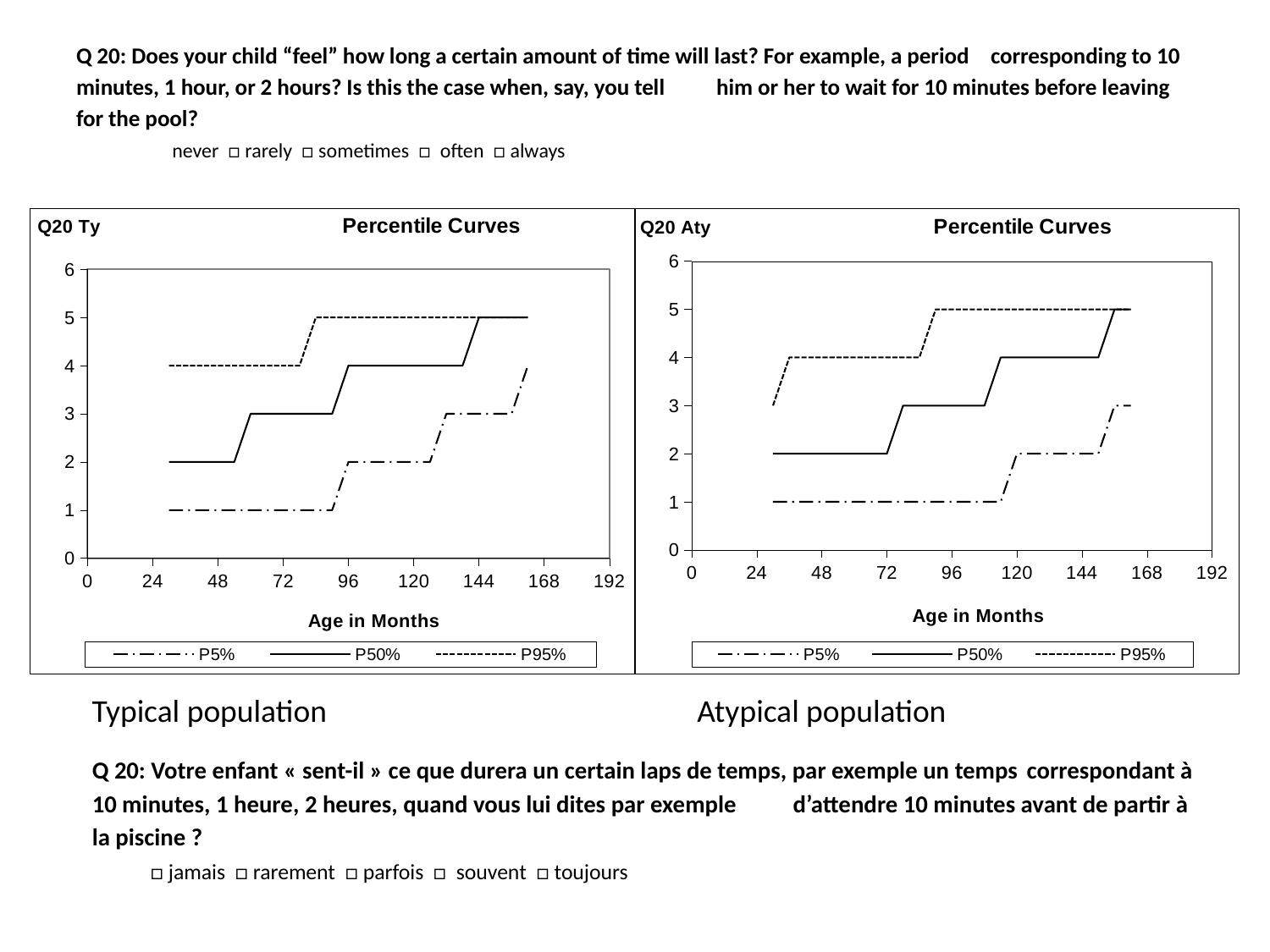
How many series does the legend of the Q20 Aty chart list? 3 What are the legend entries of the Q20 Ty chart? P5%, P50%, P95% In the Q20 Ty chart, at 120 months, which is larger: the P95% value or the P5% value? P95% In the Q20 Ty chart, what is the value of the P50% curve at 120 months? 4 What kind of chart is the Q20 Ty chart on the left? line chart In the Q20 Ty chart, what is the value of the P95% curve at 48 months? 4 In the Q20 Aty chart, what is the value of the P5% curve at 72 months? 1 In the Q20 Ty chart, does the P50% curve rise or fall as age in months increases? rise In the Q20 Ty chart, what is the value of the P5% curve at 48 months? 1 What is the x-axis title of the Q20 Aty chart? Age in Months In the Q20 Aty chart, is the value of the P50% curve at 96 months greater or less than 2? greater In the Q20 Aty chart, what is the value of the P95% curve at 144 months? 5